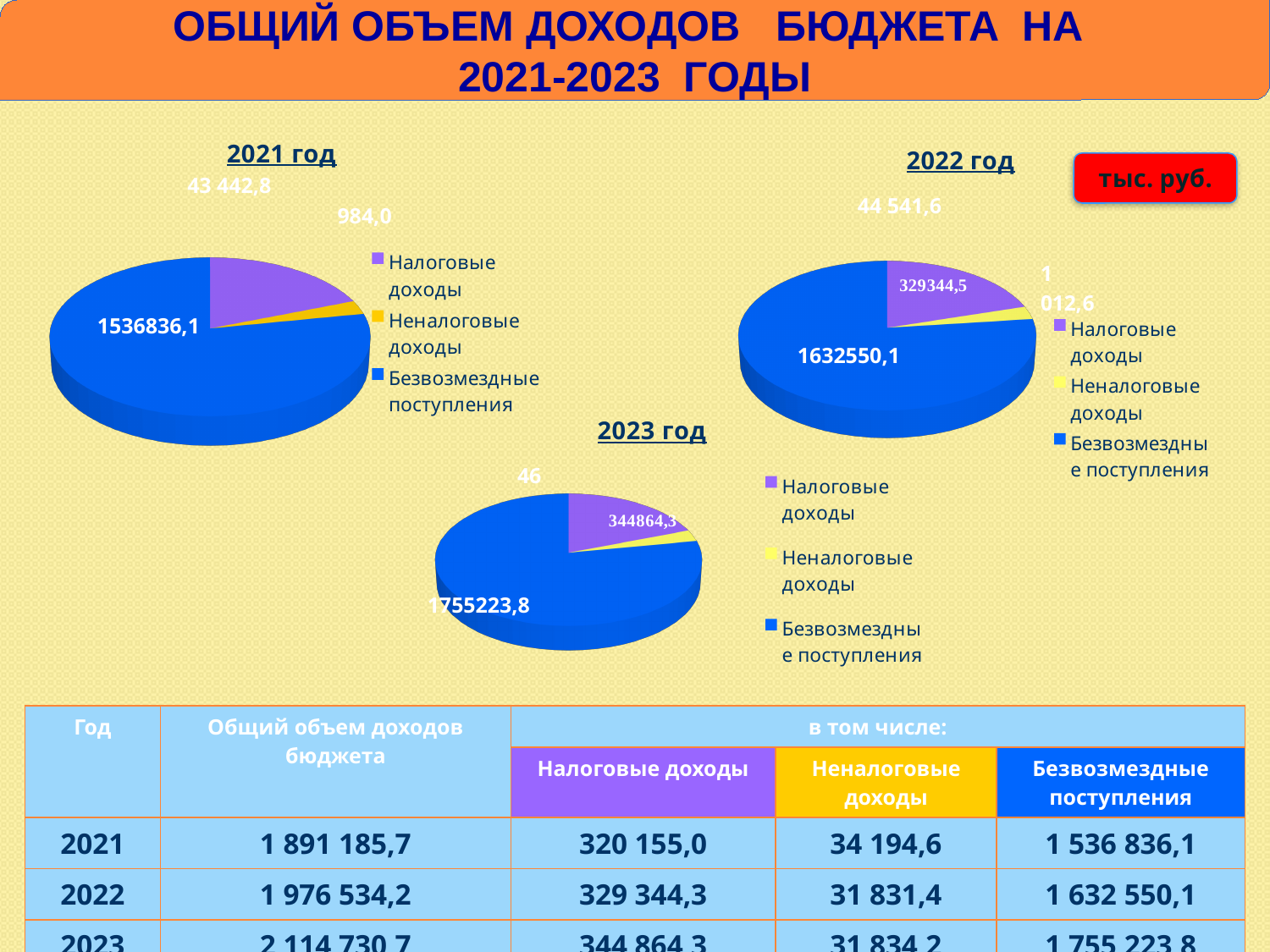
What kind of chart is used for the 2021 год chart? pie chart In the 2022 год pie chart, what is the value for Безвозмездные поступления? 1632550,1 In the 2022 год pie chart, what is the value for Налоговые доходы? 329344,5 In the 2022 год pie chart, which is larger: Налоговые доходы or Безвозмездные поступления? Безвозмездные поступления In the 2023 год pie chart, what is the value for Налоговые доходы? 344864,3 In the 2023 год pie chart, what is the value for Безвозмездные поступления? 1755223,8 In the 2022 год pie chart, which category has the smallest slice? Неналоговые доходы In the 2023 год pie chart, what is the difference between Безвозмездные поступления and Налоговые доходы? 1410359,5 How many entries does the legend of the 2021 год pie chart list? 3 How many pie charts are shown on the slide? 3 In the 2021 год pie chart, what is the value for Безвозмездные поступления? 1536836,1 In the 2023 год pie chart, which category has the largest slice? Безвозмездные поступления